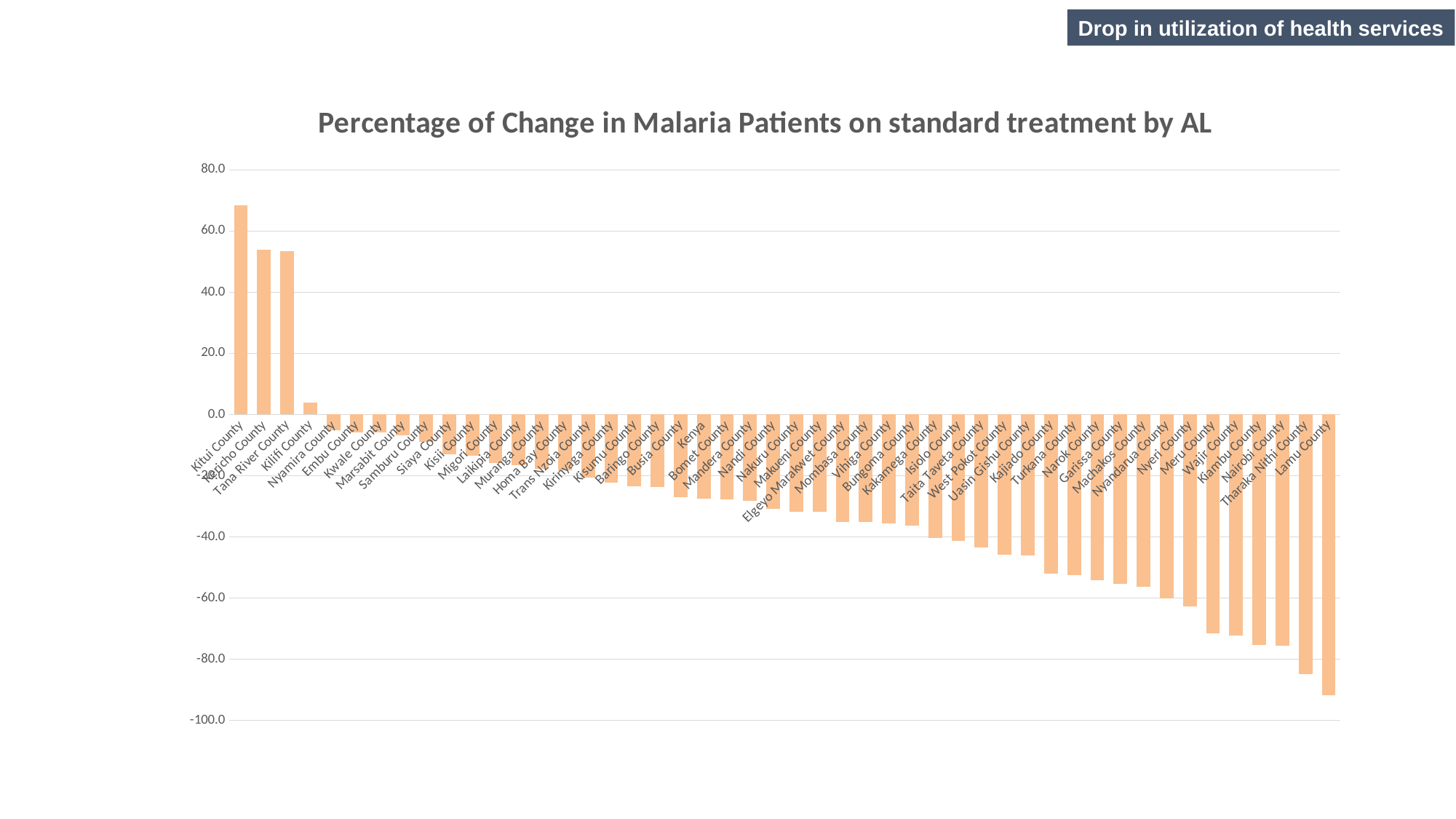
Which county has the lowest percentage change? Lamu County Which has the larger value, Tharaka Nithi County or Lamu County? Tharaka Nithi County Is the value for Kericho County greater or less than 60? less What is the title of the chart? Percentage of Change in Malaria Patients on standard treatment by AL What kind of chart is shown on the slide? bar chart Which county has the highest percentage change? Kitui County Is the value for Nyamira County greater or less than 0? less Do the values rise or fall moving from left to right along the x axis? fall Is the value for Nairobi County greater or less than -60? less Which has the larger value, Kitui County or Kericho County? Kitui County